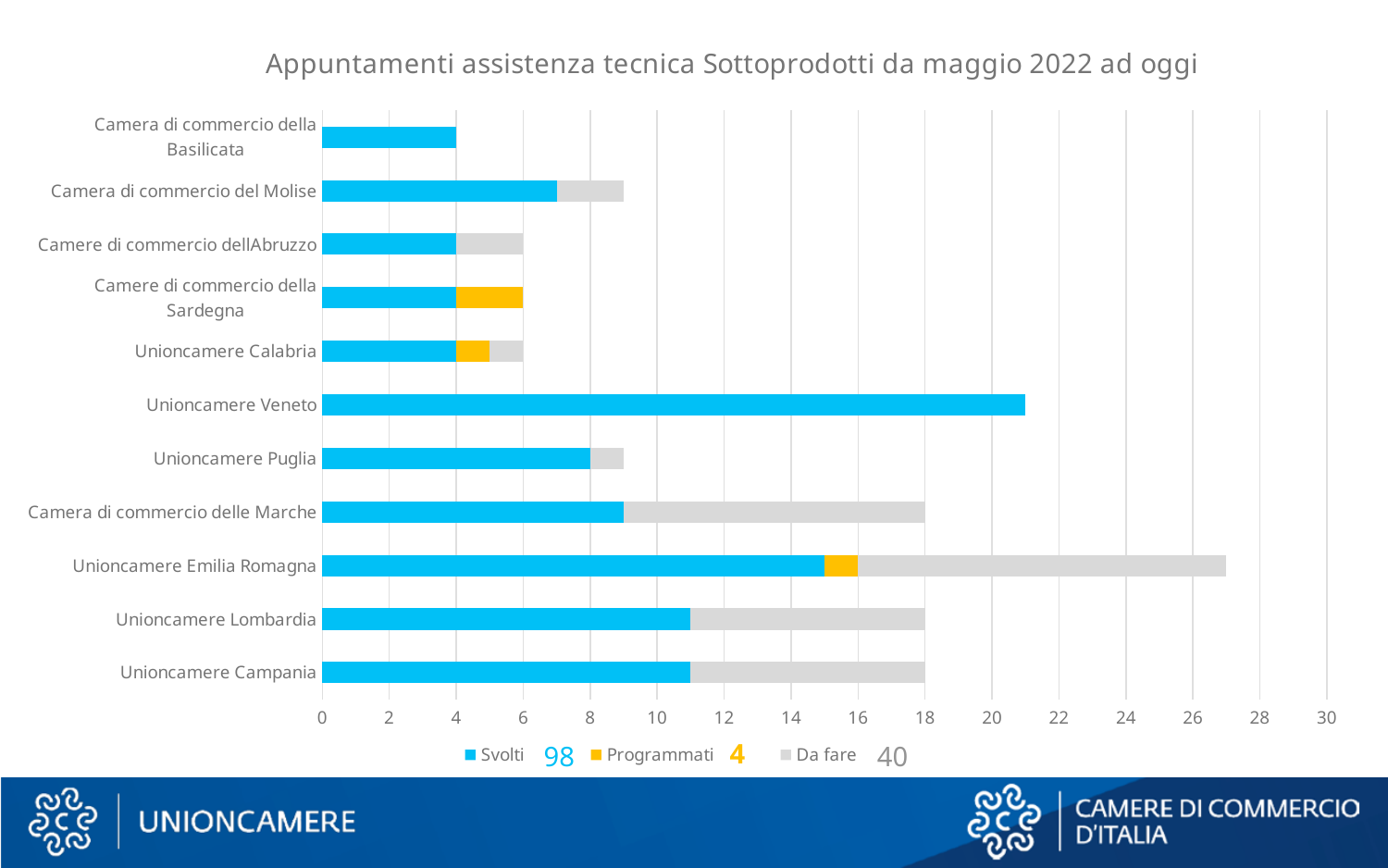
What is the total of the stacked bar for Camera di commercio delle Marche? 18 Which organisation has the longest total bar? Unioncamere Emilia Romagna Which organisation has the highest 'Svolti' value? Unioncamere Veneto Which organisation has the shortest total bar? Camera di commercio della Basilicata What is the 'Svolti' value for Unioncamere Puglia? 8 Is the total bar for Camera di commercio del Molise greater or less than 10? less What kind of chart is shown on the slide? Stacked bar chart What is the 'Svolti' value for Camera di commercio della Basilicata? 4 How many organisations (categories) are shown on the chart? 11 How many series does the legend list? 3 Which is larger: the total bar for Unioncamere Veneto or for Camera di commercio delle Marche? Unioncamere Veneto Is the 'Svolti' value for Unioncamere Veneto greater or less than 20? greater